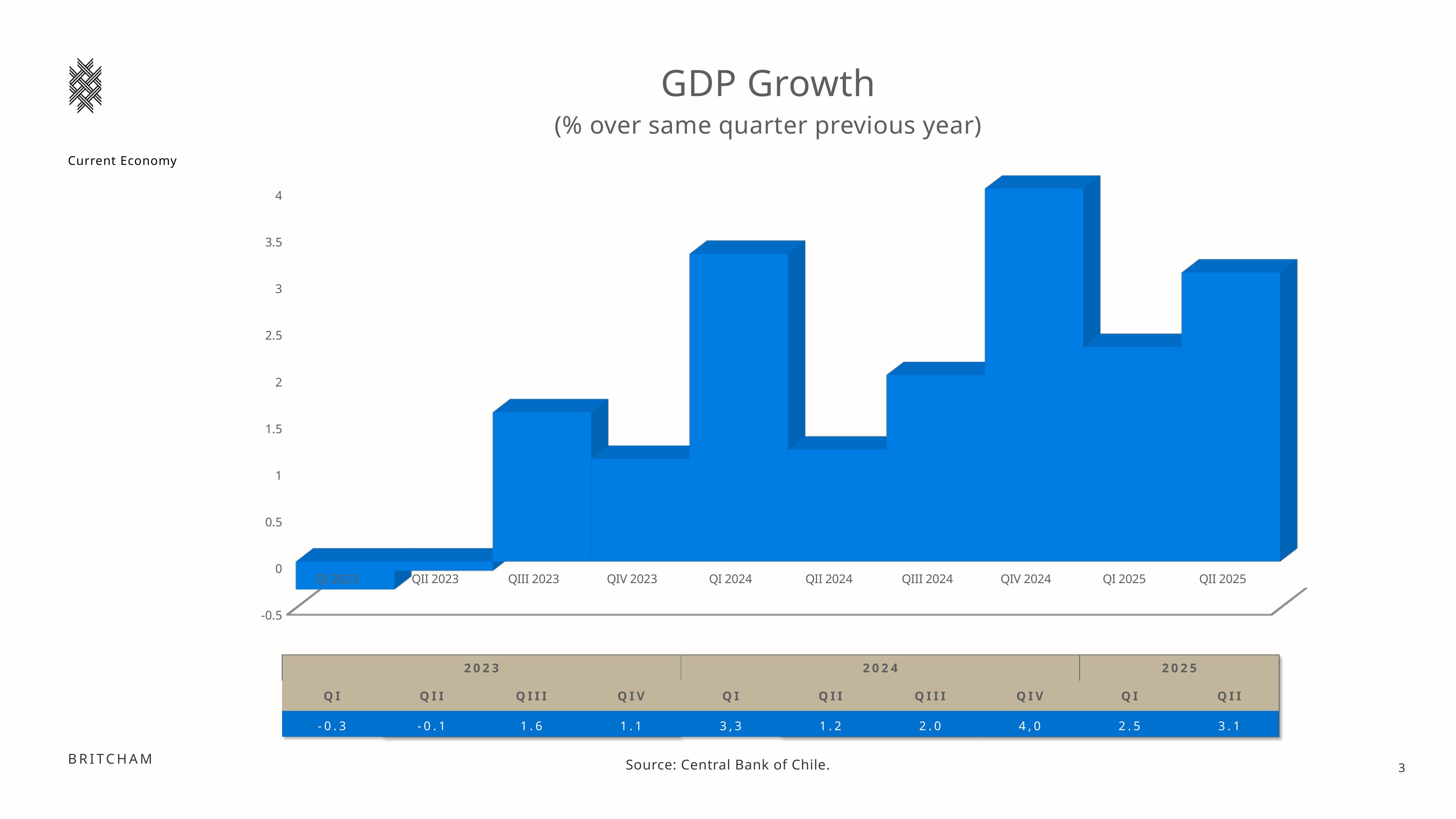
What kind of chart is shown on the slide? bar chart What is the GDP growth value for QI 2023? -0.3 How many quarters are plotted on the chart? 10 Which quarter has the highest GDP growth? QIV 2024 Which quarter has the lowest GDP growth? QI 2023 What is the difference between the GDP growth values for QI 2025 and QII 2025? 0.6 What is the subtitle shown under the chart title? (% over same quarter previous year) What is the GDP growth value for QII 2025? 3.1 Which is larger, the GDP growth for QIII 2023 or for QIV 2023? QIII 2023 What is the GDP growth value for QIV 2024? 4,0 Is the GDP growth value for QI 2024 greater or less than 3? greater Does GDP growth rise or fall from QII 2024 to QIV 2024? rise